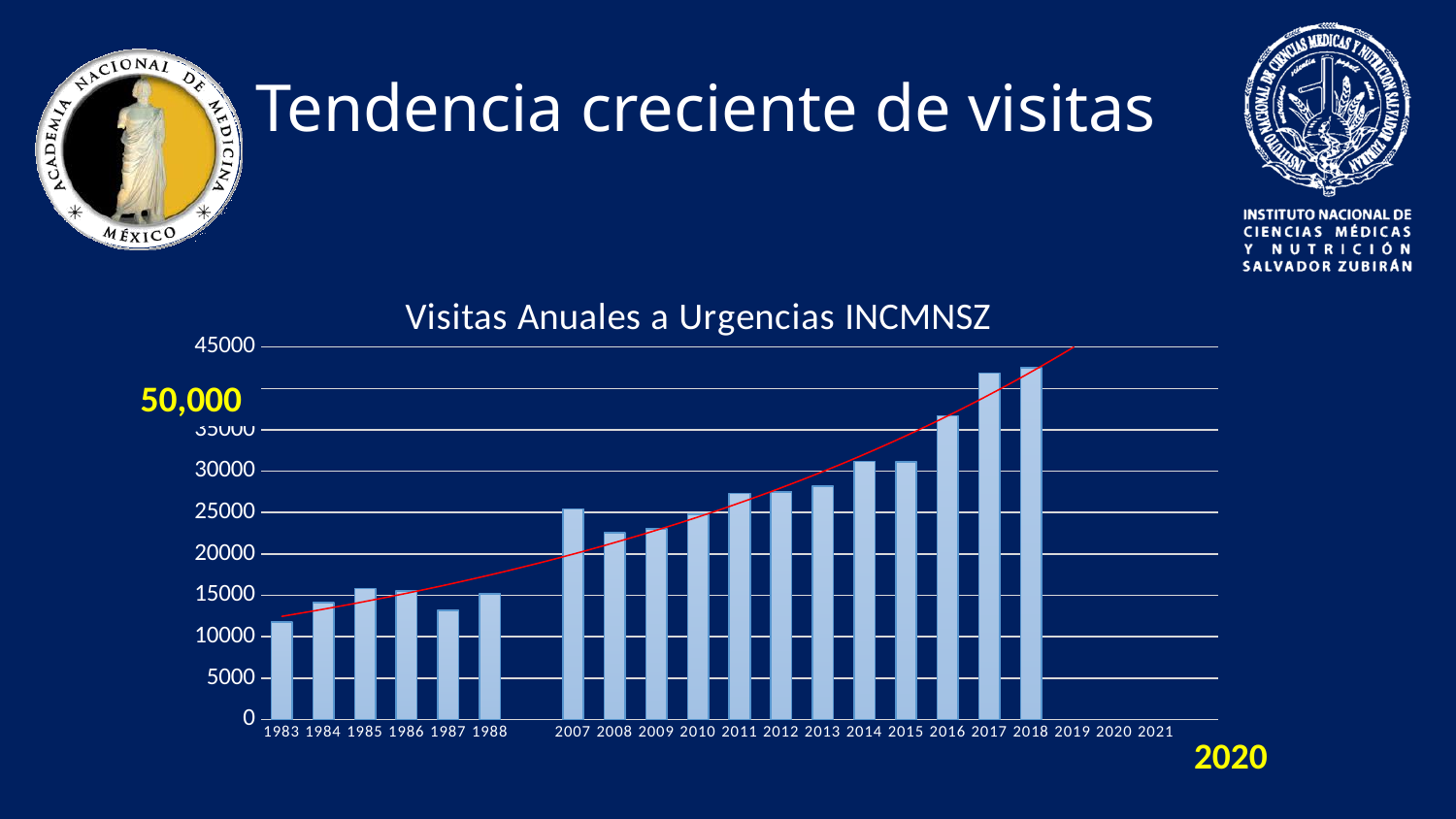
Which is larger, the value for 1985 or the value for 1987? 1985 Is the value for 2016 greater or less than 35000? greater Which is larger, the value for 2015 or the value for 2016? 2016 What kind of chart is shown on the slide? bar chart Do the values generally rise or fall from 2007 to 2018? rise How many bars are plotted in the chart? 18 Is the value for 2011 greater or less than 25000? greater What is the title of the chart? Visitas Anuales a Urgencias INCMNSZ Is the value for 1987 greater or less than 15000? less Which year has the lowest bar in the chart? 1983